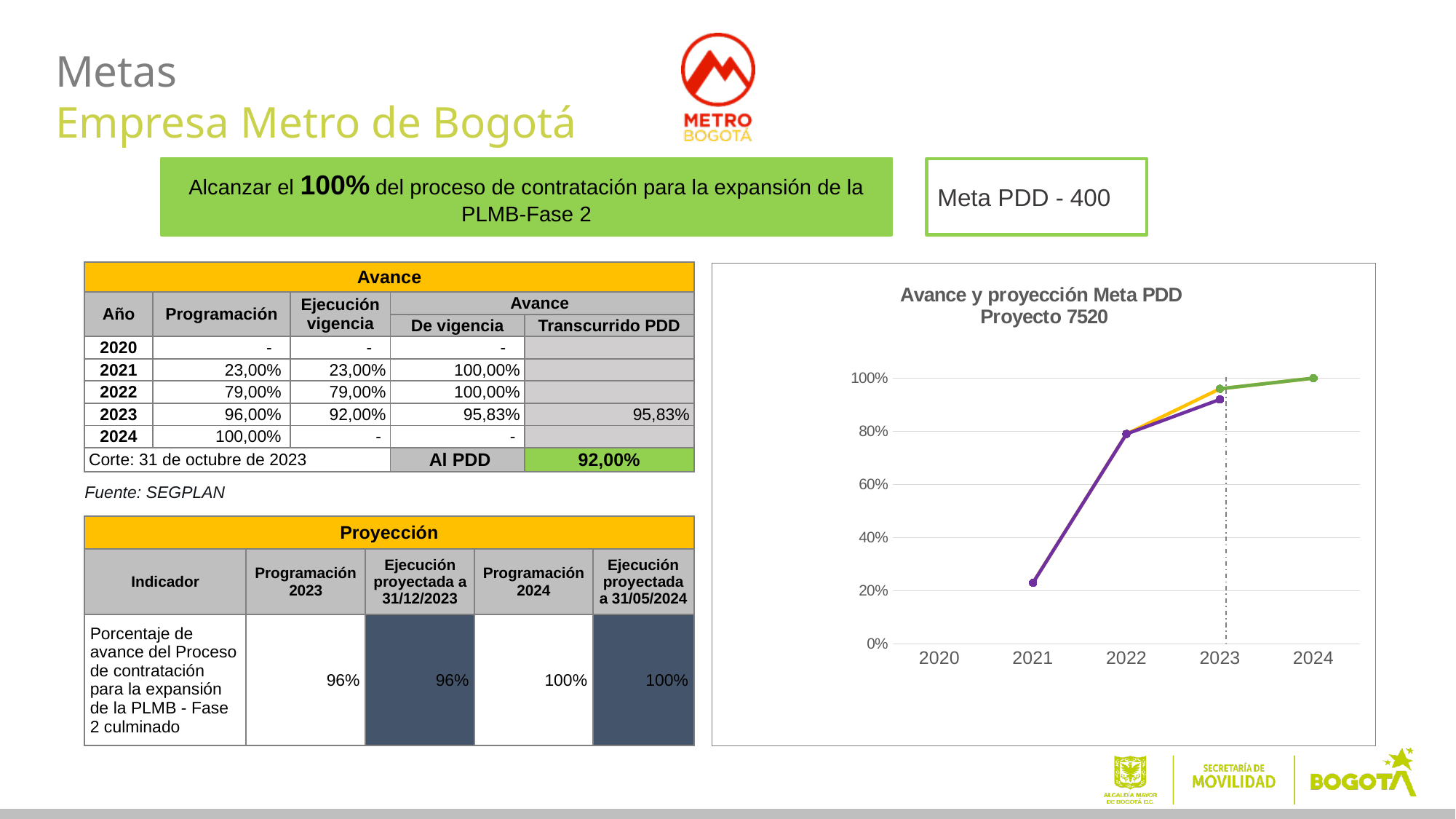
Which year has the lowest plotted value in the chart? 2021 Which year has the highest plotted value in the chart? 2024 Do the plotted values rise or fall from 2021 to 2024? rise Is the value plotted for 2022 greater or less than 60%? greater Is the value plotted for 2021 greater or less than 40%? less What kind of chart is shown on the slide? line chart What value does the green line reach at 2024? 100% What is the title of the chart? Avance y proyección Meta PDD Proyecto 7520 How many years are shown on the x axis of the chart? 5 Is the value plotted for 2021 greater or less than 20%? greater Which year is the first one on the x axis of the chart? 2020